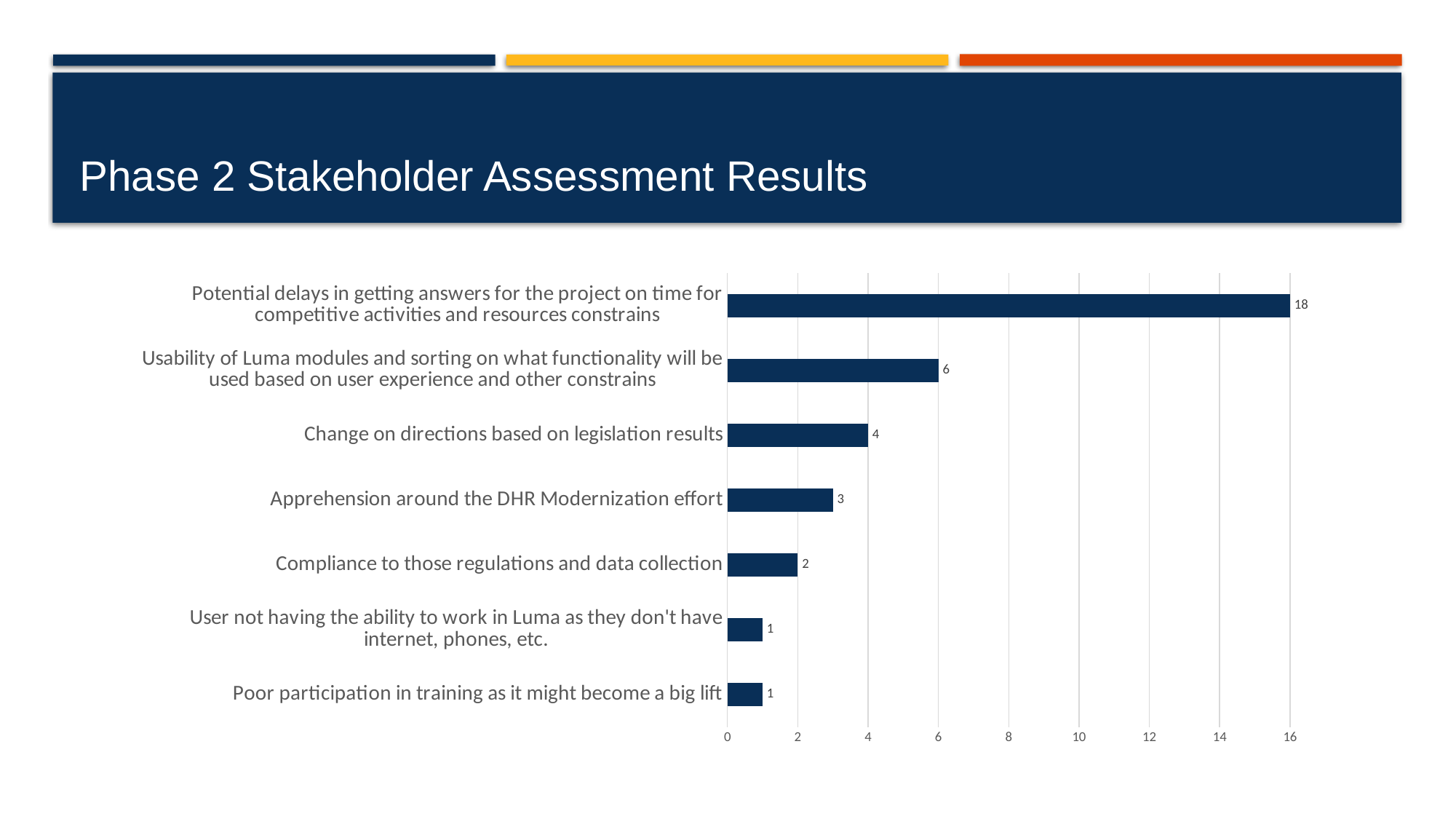
Is the value for "Potential delays in getting answers for the project on time for competitive activities and resources constrains" greater or less than 10? greater What kind of chart is shown on the slide? bar chart What is the difference between the values for "Change on directions based on legislation results" and "Compliance to those regulations and data collection"? 2 What is the value for "Usability of Luma modules and sorting on what functionality will be used based on user experience and other constrains"? 6 Which is larger: the value for "Apprehension around the DHR Modernization effort" or the value for "Usability of Luma modules and sorting on what functionality will be used based on user experience and other constrains"? Usability of Luma modules and sorting on what functionality will be used based on user experience and other constrains What is the value for "Compliance to those regulations and data collection"? 2 Which category has the highest value? Potential delays in getting answers for the project on time for competitive activities and resources constrains What is the value for "Apprehension around the DHR Modernization effort"? 3 How many categories are plotted in the chart? 7 What is the title of the slide containing the chart? Phase 2 Stakeholder Assessment Results What is the value for "Poor participation in training as it might become a big lift"? 1 What is the value for "Change on directions based on legislation results"? 4